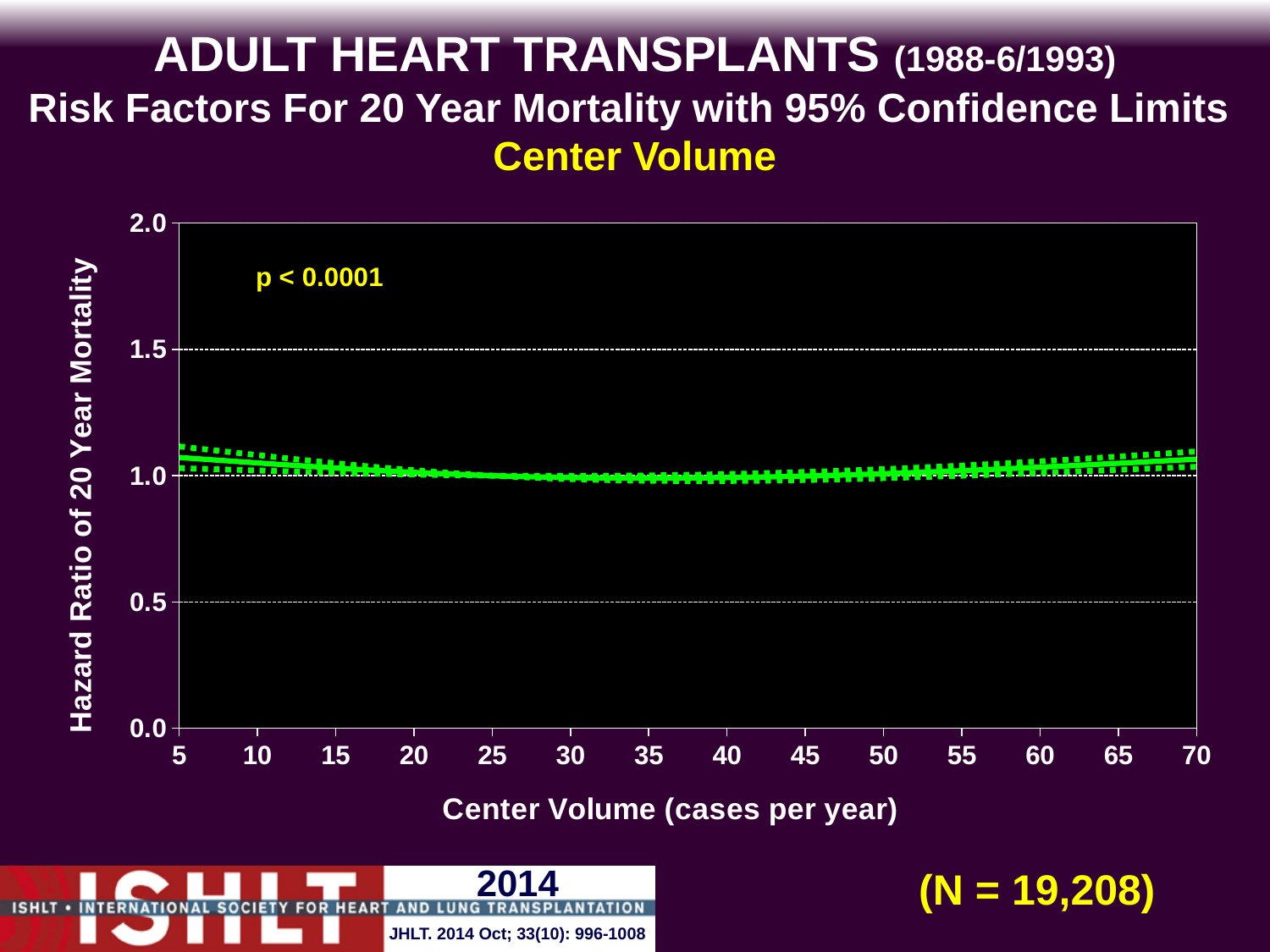
Does the hazard ratio rise or fall as center volume increases from 5 to 30 cases per year? fall Is the hazard ratio at a center volume of 5 cases per year greater or less than 1.5? less What is the lowest center volume shown on the x axis? 5 Is the hazard ratio at a center volume of 35 cases per year greater or less than 1.5? less What p-value is printed on the chart? p < 0.0001 Does the hazard ratio rise or fall as center volume increases from 40 to 70 cases per year? rise What kind of chart is shown on the slide? line chart What is the highest value shown on the y axis? 2.0 How many tick labels are shown on the x axis? 14 What sample size (N) is printed on the slide? N = 19,208 What is the highest center volume shown on the x axis? 70 Is the hazard ratio at a center volume of 70 cases per year greater or less than 0.5? greater